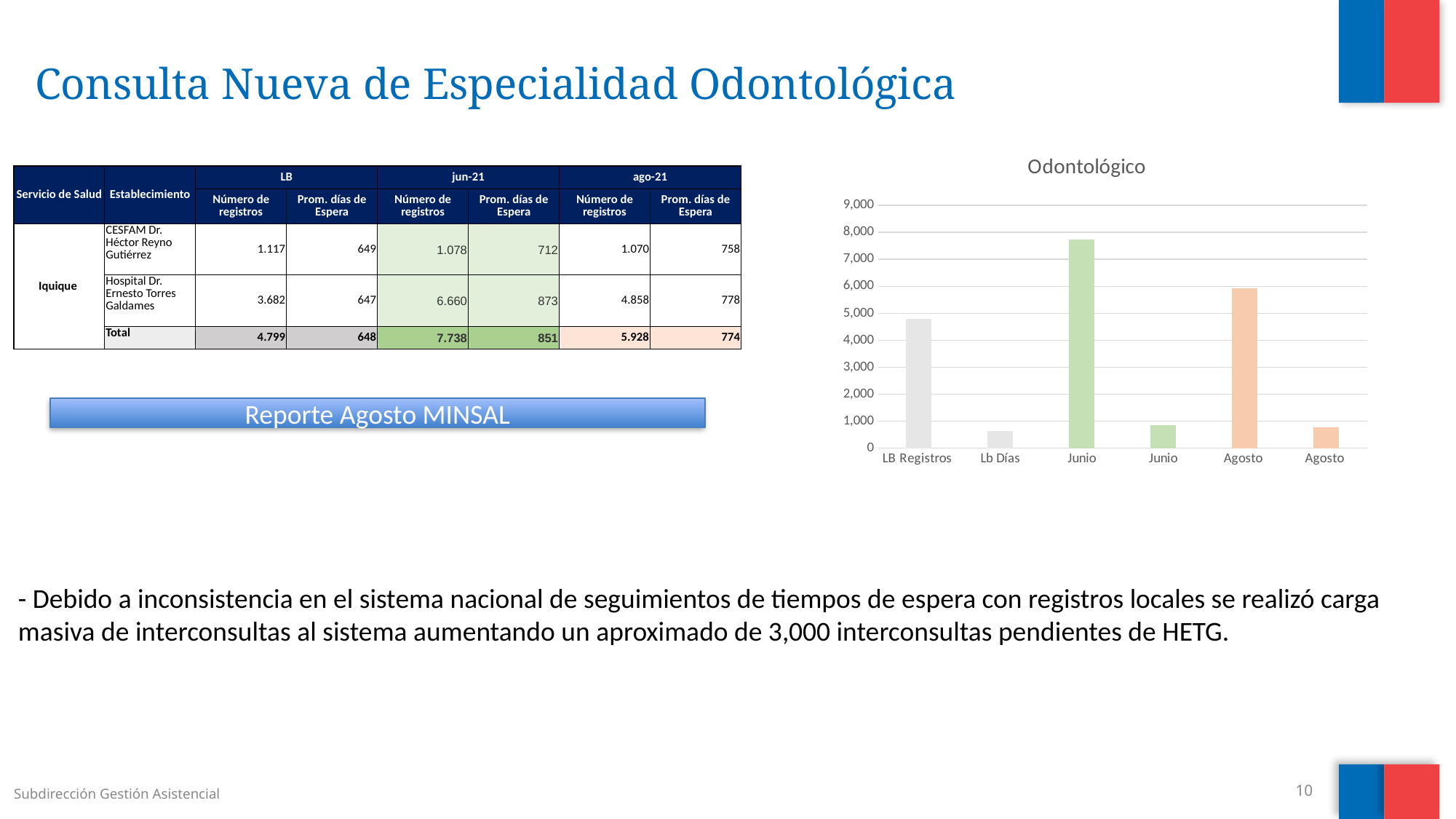
In the Odontológico chart, is the value for Lb Días greater or less than 1,000? less In the Odontológico chart, is the value for LB Registros greater or less than 4,000? greater How many bars are plotted in the Odontológico chart? 6 What kind of chart is shown on the slide? bar chart In the Odontológico chart, which bar is the tallest? Junio (first Junio bar) What is the highest value shown on the vertical axis of the Odontológico chart? 9,000 What is the title of the chart on the slide? Odontológico In the Odontológico chart, is the value of the first Junio bar greater or less than 7,000? greater In the Odontológico chart, which is larger: the LB Registros bar or the first Agosto bar? Agosto In the Odontológico chart, which bar is the shortest? Lb Días In the Odontológico chart, which is larger: the second Junio bar or the second Agosto bar? Junio